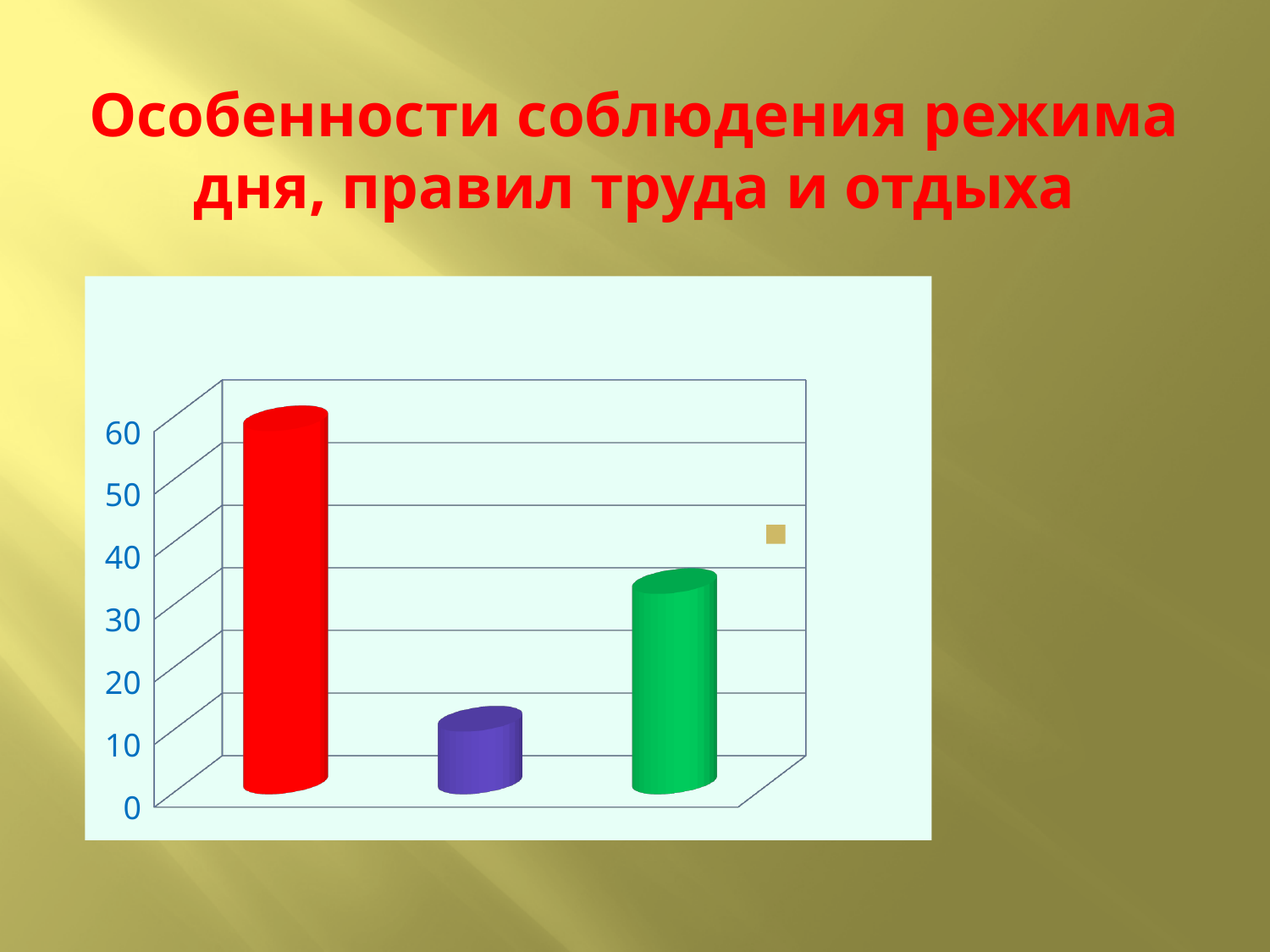
Which bar is the tallest in the chart? the red bar (first from the left) How many bars are plotted in the chart? 3 Which bar is the shortest in the chart? the purple bar (middle) Which is larger, the green bar or the purple bar? the green bar Does the value rise or fall from the first bar to the second bar? fall What kind of chart is shown on the slide? bar chart Is the value of the purple bar greater or less than 20? less What is the highest value shown on the vertical axis? 60 Is the value of the green bar greater or less than 40? less What colour is the tallest bar in the chart? red Is the value of the red bar greater or less than 50? greater